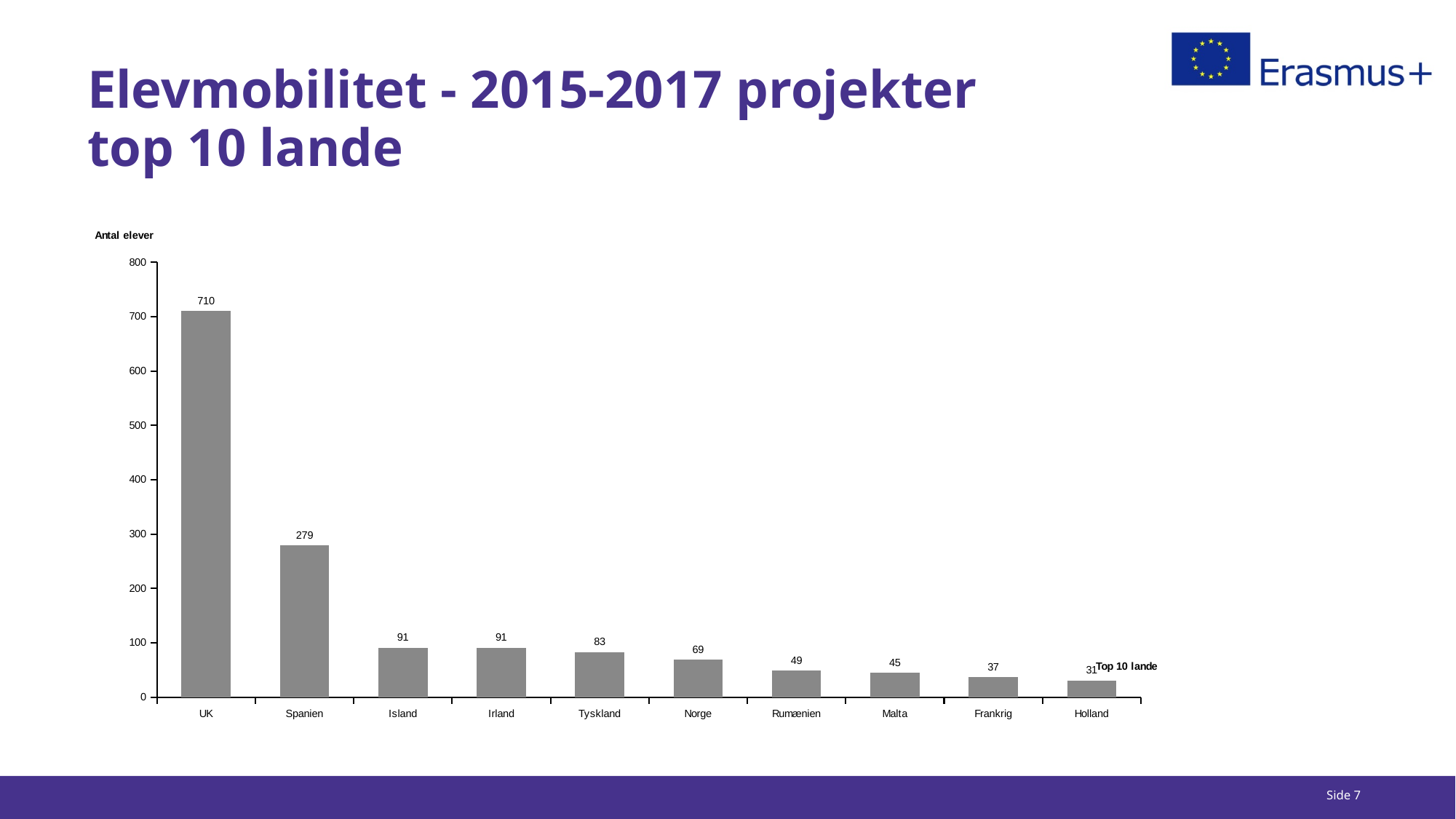
What is the difference between the values for Norge and Rumænien? 20 Which country has the lowest number of elever? Holland What is the label on the vertical axis of the chart? Antal elever What is the difference between the values for UK and Spanien? 431 What is the value for UK? 710 What is the value for Holland? 31 What is the value for Spanien? 279 Which is larger, the value for Malta or the value for Frankrig? Malta What is the value for Tyskland? 83 How many countries are shown on the chart? 10 What kind of chart is shown on the slide? bar chart Which country has the highest number of elever? UK